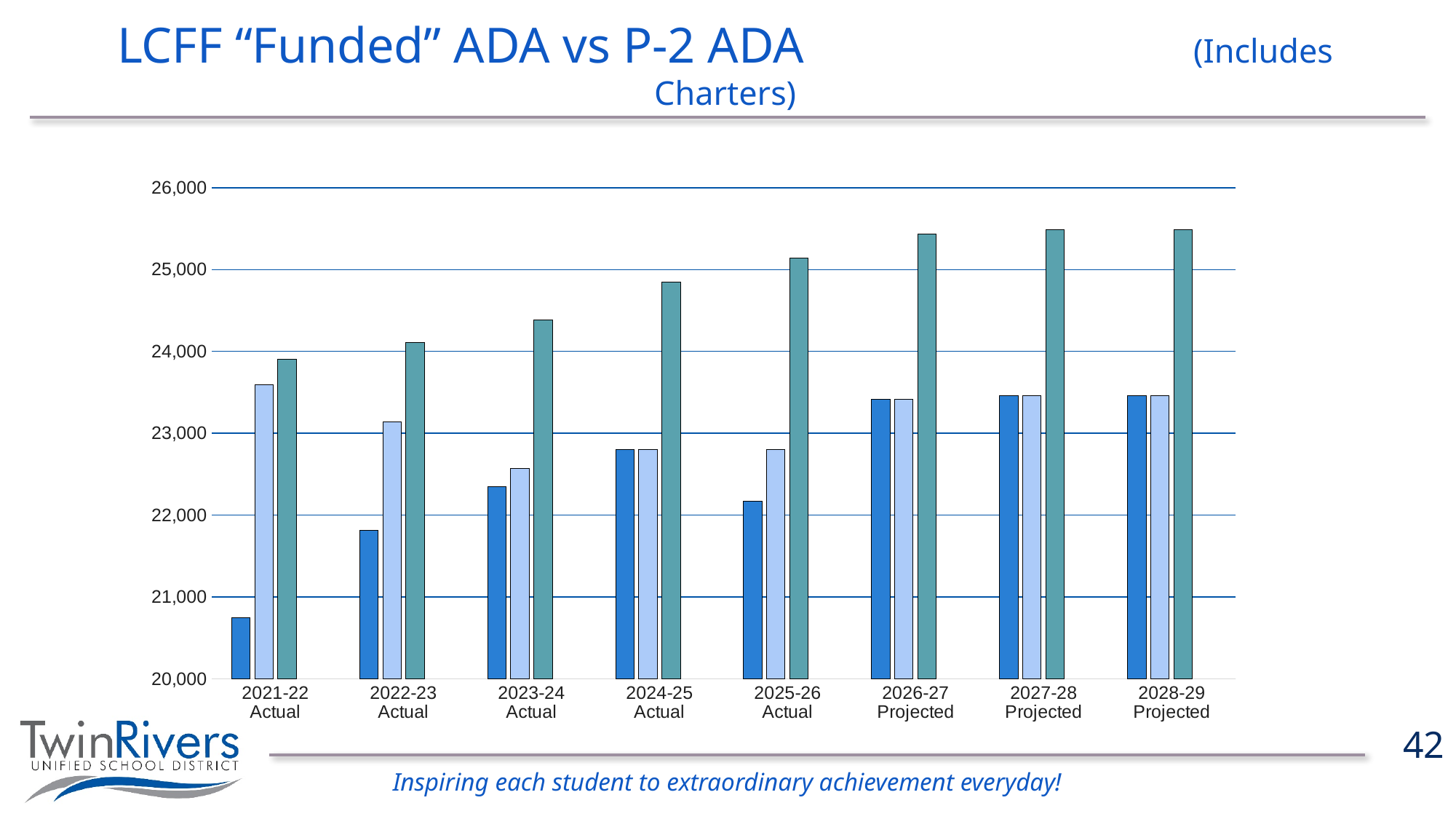
How many of the fiscal years on the x axis are labelled "Projected"? 3 Is the dark blue bar for 2021-22 Actual greater or less than 21,000? less How many fiscal-year categories are shown on the x axis? 8 How many bars are plotted for each fiscal year? 3 Is the dark blue bar for 2026-27 Projected greater or less than 23,000? greater Is the teal bar for 2024-25 Actual greater or less than 25,000? less Do the teal bars rise or fall from 2021-22 to 2028-29? rise In which fiscal year is the dark blue bar the lowest? 2021-22 Actual For 2021-22 Actual, which is larger: the dark blue bar or the light blue bar? the light blue bar What kind of chart is shown on the slide? bar chart